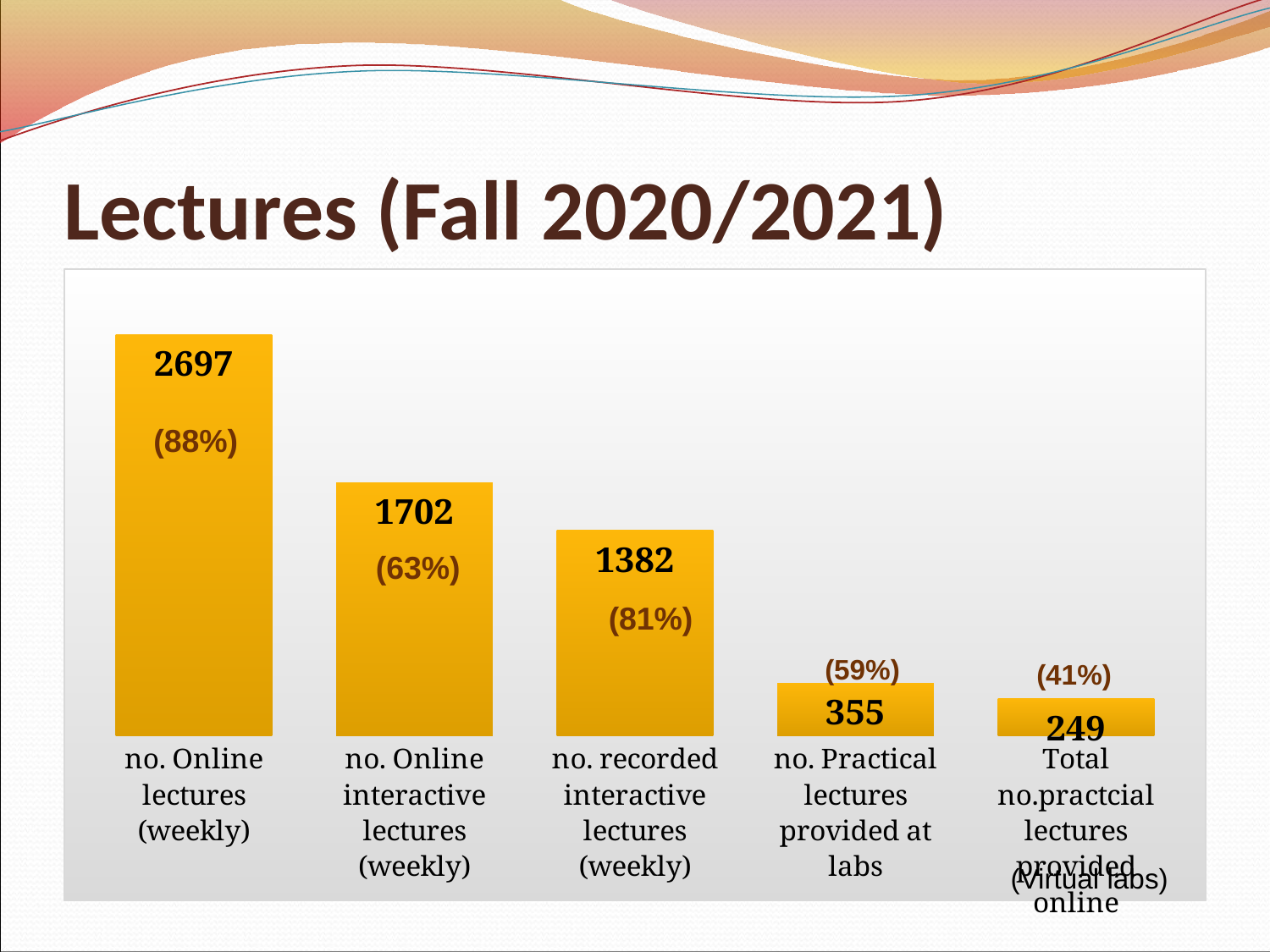
What is the value for no. Online lectures (weekly)? 2697 Which category has the highest value? no. Online lectures (weekly) Which is larger: no. Online interactive lectures (weekly) or no. recorded interactive lectures (weekly)? no. Online interactive lectures (weekly) What percentage is shown for no. recorded interactive lectures (weekly)? 81% What type of chart is shown on the slide? bar chart What is the value for no. Online interactive lectures (weekly)? 1702 What is the difference between no. Online lectures (weekly) and no. Online interactive lectures (weekly)? 995 What is the value for no. Practical lectures provided at labs? 355 What is the value for no. recorded interactive lectures (weekly)? 1382 Which category has the lowest value? Total no.practcial lectures provided online What is the difference between no. Practical lectures provided at labs and Total no.practcial lectures provided online? 106 How many categories are shown in the chart? 5